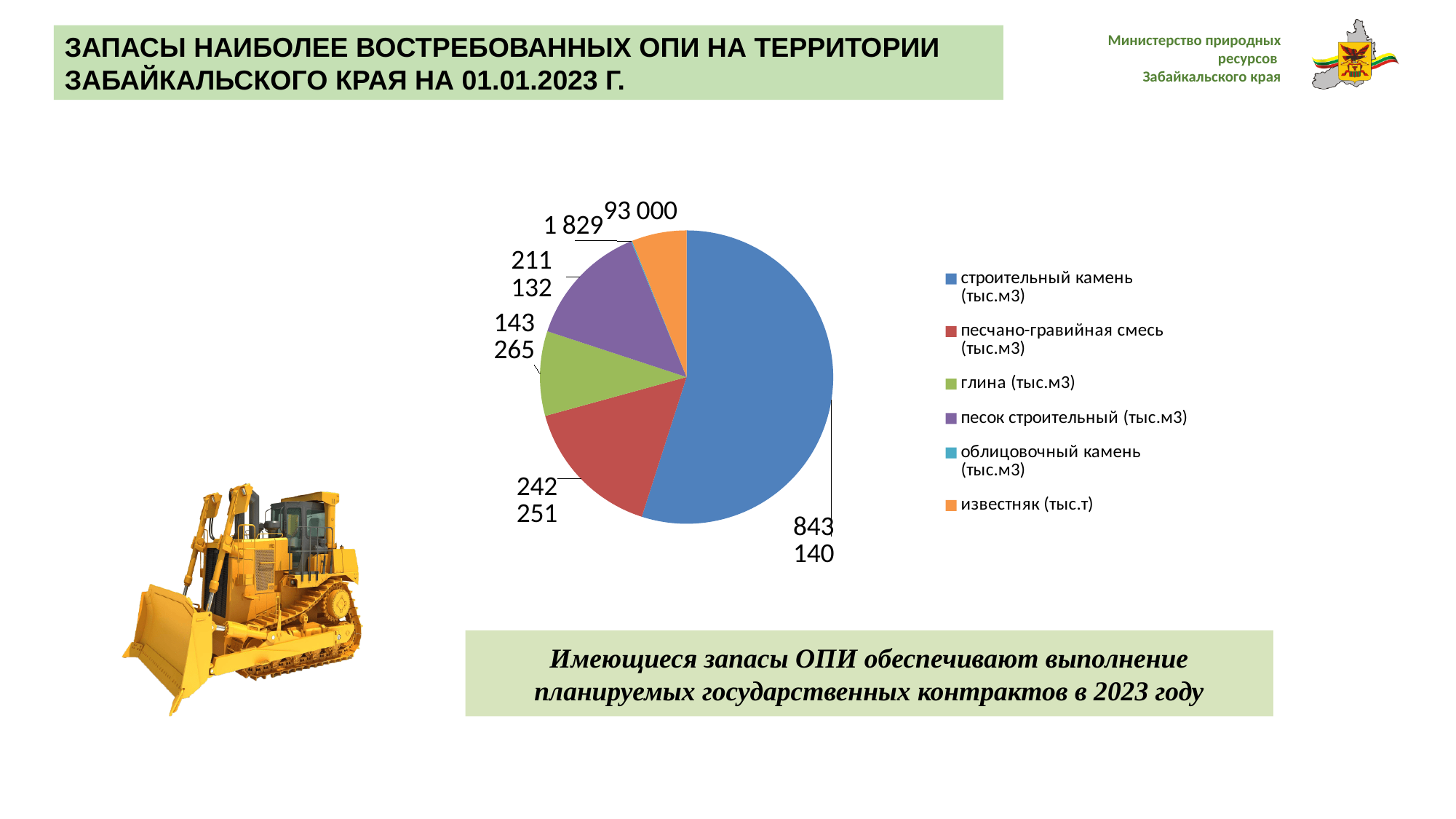
Which category has the smallest slice of the pie? облицовочный камень (тыс.м3) What is the value shown for песок строительный (тыс.м3)? 211 132 What colour is the slice for известняк (тыс.т)? orange What is the value shown for песчано-гравийная смесь (тыс.м3)? 242 251 What is the value shown for строительный камень (тыс.м3)? 843 140 What is the difference between the values for строительный камень and песчано-гравийная смесь? 600 889 What is the value shown for известняк (тыс.т)? 93 000 Which category has the largest slice of the pie? строительный камень (тыс.м3) Which is larger, the value for глина or the value for песок строительный? песок строительный What kind of chart is shown on the slide? pie chart How many categories are shown in the pie chart? 6 What is the value shown for глина (тыс.м3)? 143 265